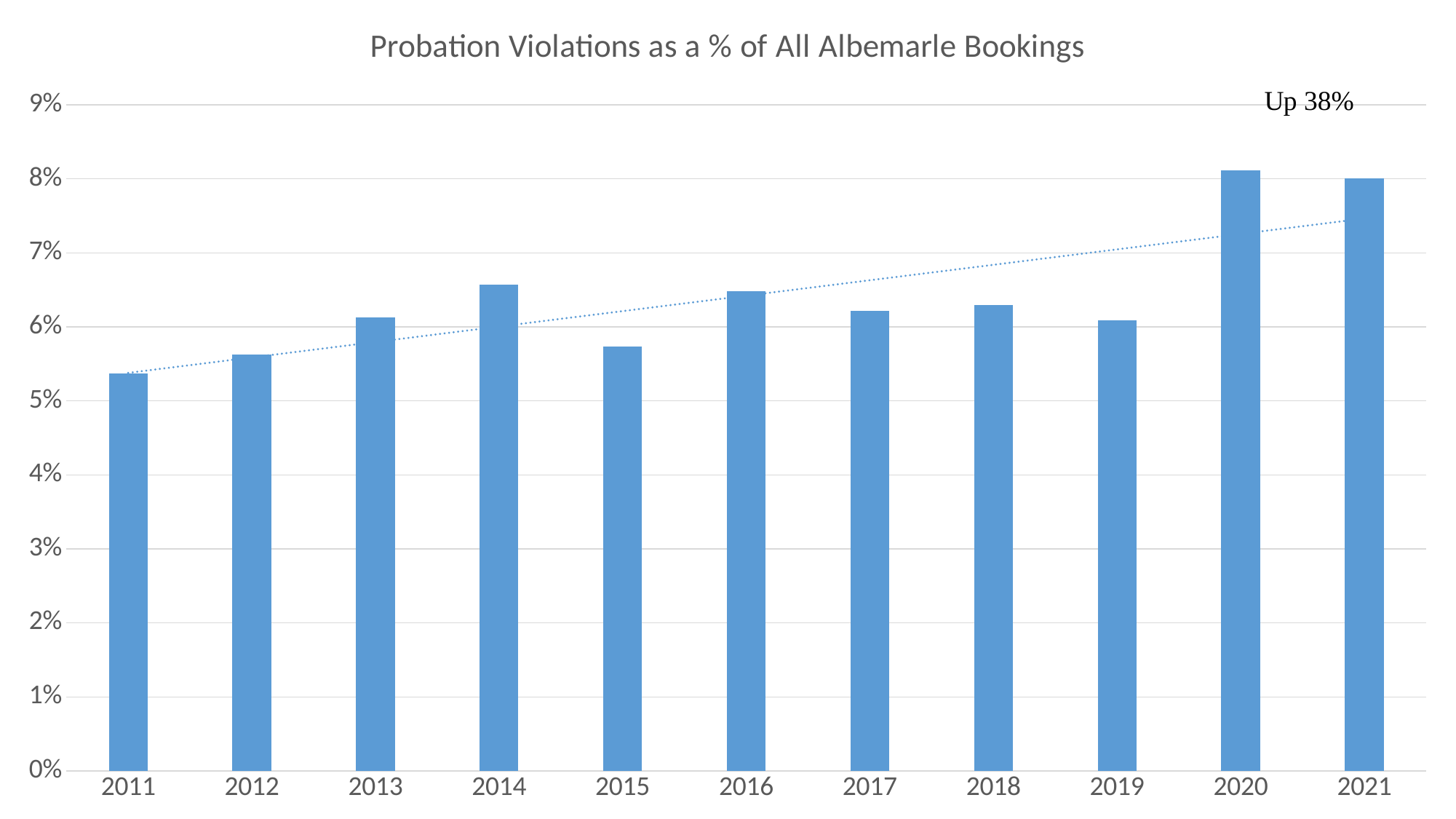
Which year has the larger value, 2019 or 2020? 2020 What kind of chart is shown on the slide? bar chart Is the value for 2015 greater or less than 6%? less Which year has the lowest probation violation percentage? 2011 What text annotation appears at the top right of the chart? Up 38% Is the value for 2020 greater or less than 7%? greater How many years are plotted on the x axis of the chart? 11 Which year has the larger value, 2014 or 2015? 2014 Is the value for 2014 greater or less than 6%? greater What is the title of the chart? Probation Violations as a % of All Albemarle Bookings Do the values generally rise or fall from 2011 to 2021? rise